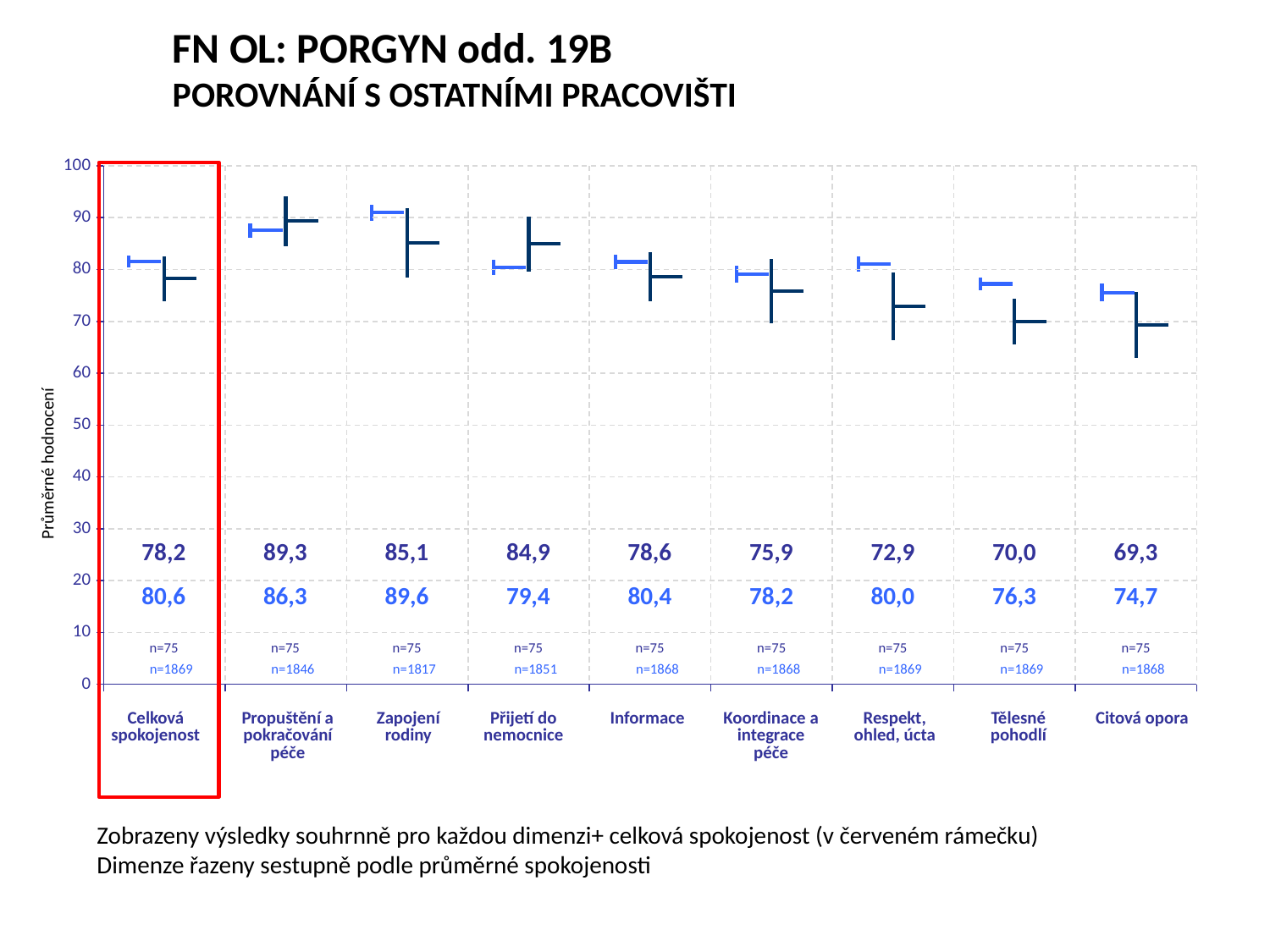
How many categories are shown on the x axis? 9 Which category has the highest dark blue (n=75) value? Propuštění a pokračování péče What is the dark blue (n=75) value for Tělesné pohodlí? 70,0 What is the title of the y axis? Průměrné hodnocení Which category has the highest light blue (large n) value? Zapojení rodiny What is the dark blue (n=75) value for Celková spokojenost? 78,2 What is the light blue (n=1817) value for Zapojení rodiny? 89,6 For Zapojení rodiny, which is larger: the dark blue value or the light blue value? the light blue value (89,6) Which category has the lowest dark blue (n=75) value? Citová opora For Celková spokojenost, what is the difference between the light blue value (80,6) and the dark blue value (78,2)? 2,4 For Respekt, ohled, úcta, what is the difference between the light blue value (80,0) and the dark blue value (72,9)? 7,1 Do the dark blue (n=75) values rise or fall from Propuštění a pokračování péče to Citová opora? fall